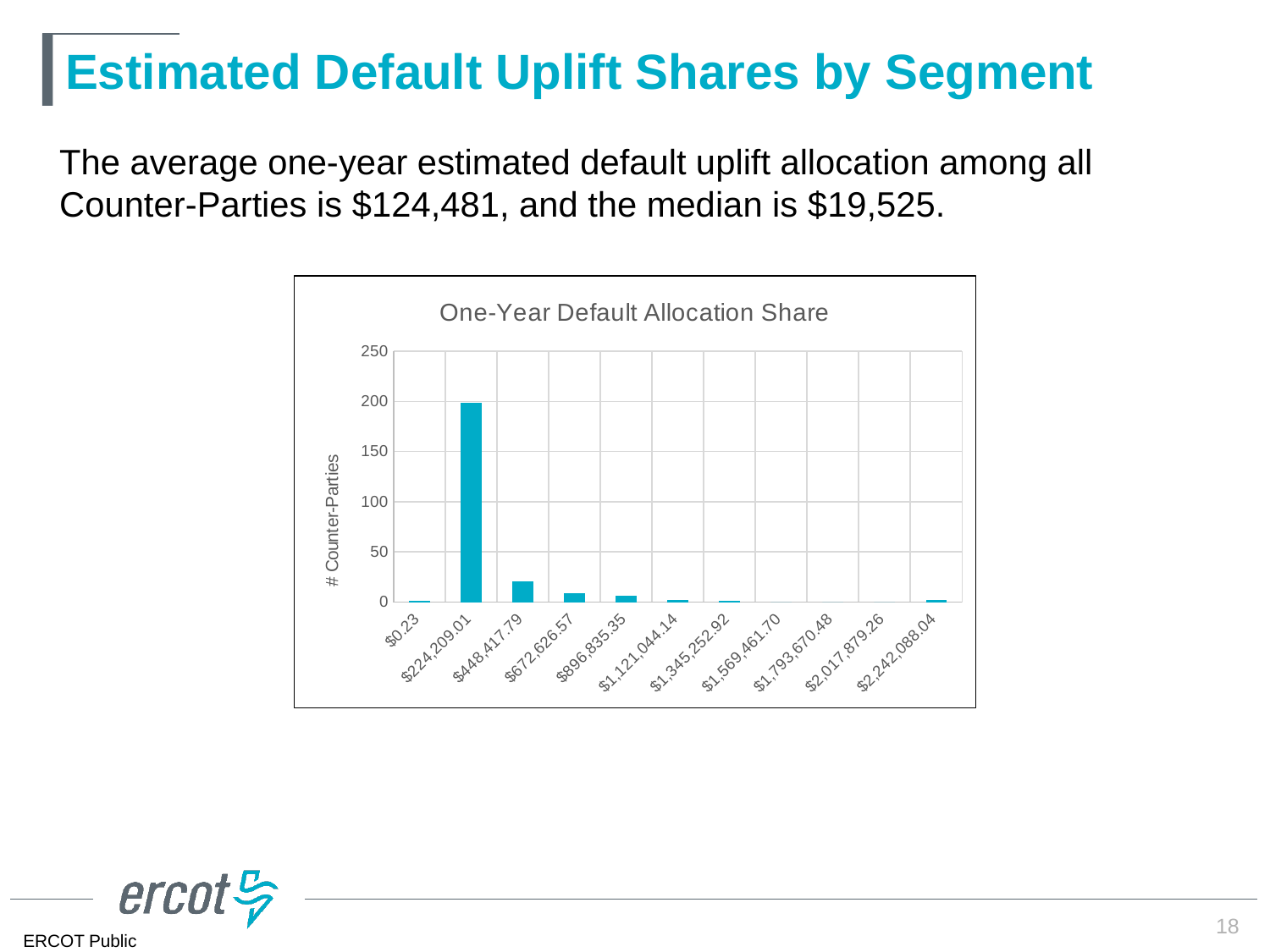
Which has more Counter-Parties, $448,417.79 or $672,626.57? $448,417.79 Is the value for $672,626.57 greater or less than 50? less What kind of chart is shown on the slide? bar chart What is the label on the vertical axis of the chart? # Counter-Parties What is the title of the chart? One-Year Default Allocation Share Is the value for $224,209.01 greater or less than 250? less Which has more Counter-Parties, $224,209.01 or $448,417.79? $224,209.01 Which category has the highest number of Counter-Parties? $224,209.01 How many categories are shown along the x axis of the chart? 11 Is the value for $224,209.01 greater or less than 150? greater After the tallest bar at $224,209.01, do the values generally rise or fall moving right along the x axis? fall